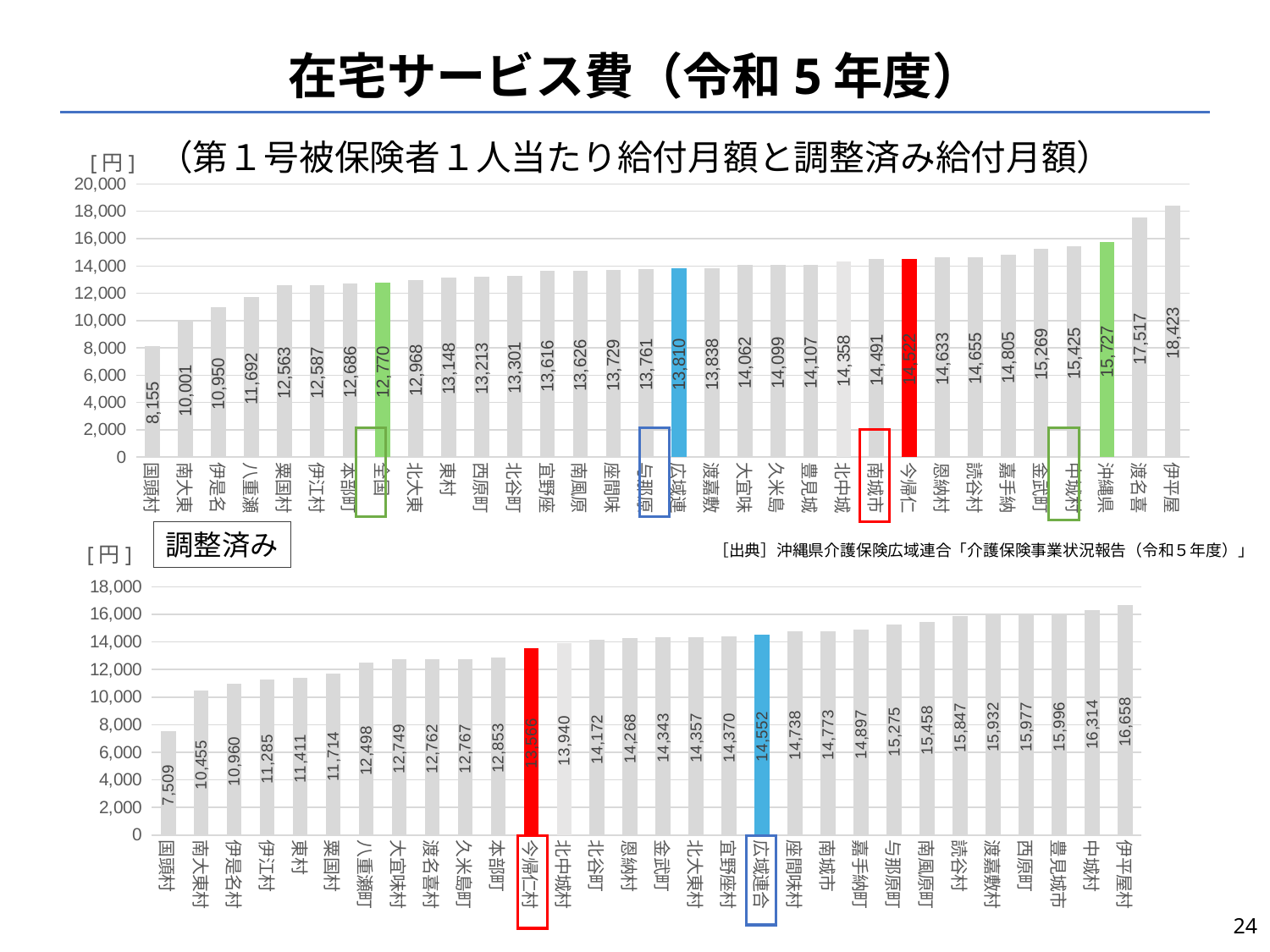
In the bottom chart (調整済み), what is the difference between 広域連合 and 今帰仁村? 986 In the bottom chart (調整済み), what is the value for 今帰仁村? 13,566 In the bottom chart (調整済み), what is the value for 広域連合? 14,552 How many categories are plotted in the bottom chart (調整済み)? 30 In the top chart, which category has the highest value? 伊平屋 What type of chart is the top chart? Bar chart In the bottom chart (調整済み), which is larger, 中城村 or 豊見城市? 中城村 In the top chart, what is the value for 広域連合? 13,810 In the top chart, what is the difference between 沖縄県 and 全国? 2,957 In the bottom chart (調整済み), which category has the highest value? 伊平屋村 In the top chart (第１号被保険者１人当たり給付月額), what is the value for 今帰仁? 14,522 In the top chart, which category has the lowest value? 国頭村